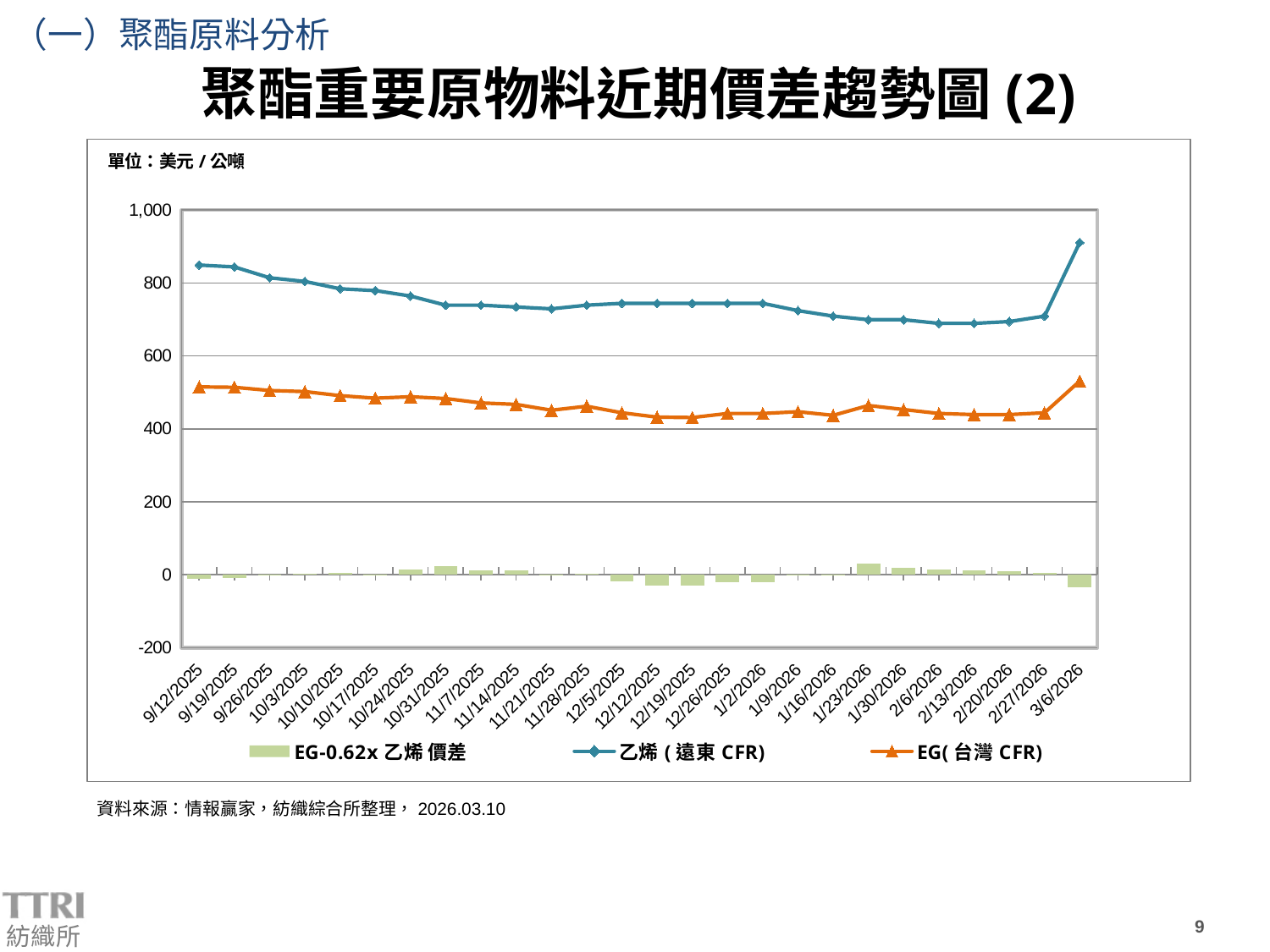
What kind of chart is this? A combination of line chart and bar chart On which date is the EG-0.62x 乙烯 價差 bar highest? 1/23/2026 Does the 乙烯 ( 遠東 CFR) line rise or fall from 9/12/2025 to 11/21/2025? fall How many series does the legend list? 3 Is the value for 乙烯 ( 遠東 CFR) on 2/6/2026 greater or less than 800? less On which date is the 乙烯 ( 遠東 CFR) value highest? 3/6/2026 How many dates are shown on the x axis? 26 Which series is drawn as bars? EG-0.62x 乙烯 價差 Is the value for 乙烯 ( 遠東 CFR) on 9/12/2025 greater or less than 800? greater Which is larger on 1/2/2026, 乙烯 ( 遠東 CFR) or EG( 台灣 CFR)? 乙烯 ( 遠東 CFR) Is the value for EG( 台灣 CFR) on 12/12/2025 greater or less than 500? less What unit is stated for the values in the chart? 美元 / 公噸